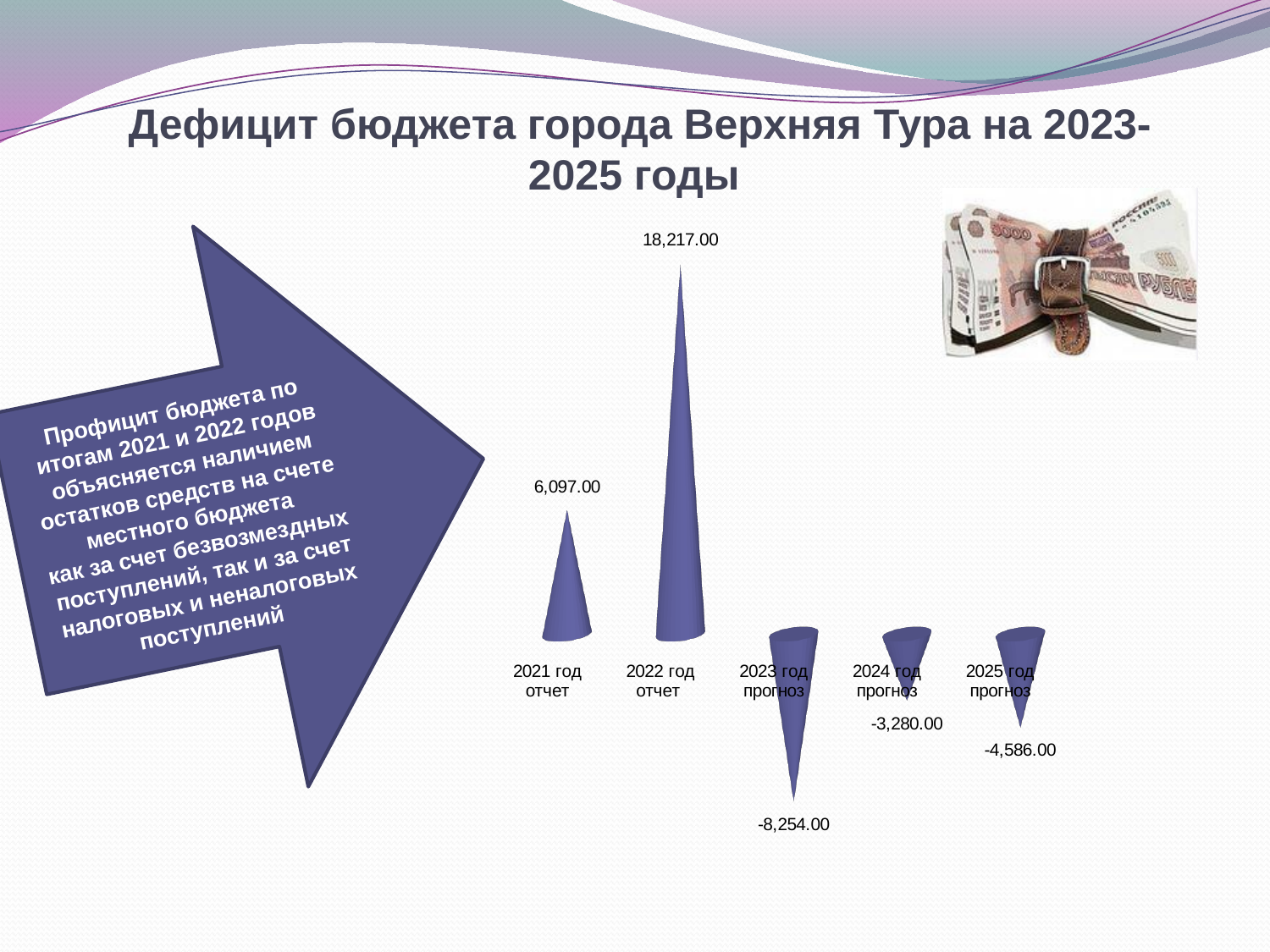
What is the value for 2024 год прогноз? -3,280.00 What kind of chart is shown on the slide? Bar chart What is the value for 2022 год отчет? 18,217.00 Which category has the lowest value? 2023 год прогноз What is the value for 2021 год отчет? 6,097.00 Which is larger, the value for 2024 год прогноз or the value for 2025 год прогноз? 2024 год прогноз What is the title of the slide containing the chart? Дефицит бюджета города Верхняя Тура на 2023-2025 годы What is the value for 2023 год прогноз? -8,254.00 What is the value for 2025 год прогноз? -4,586.00 Which category has the highest value? 2022 год отчет How many categories are shown in the chart? 5 What is the difference between the values for 2022 год отчет and 2021 год отчет? 12,120.00